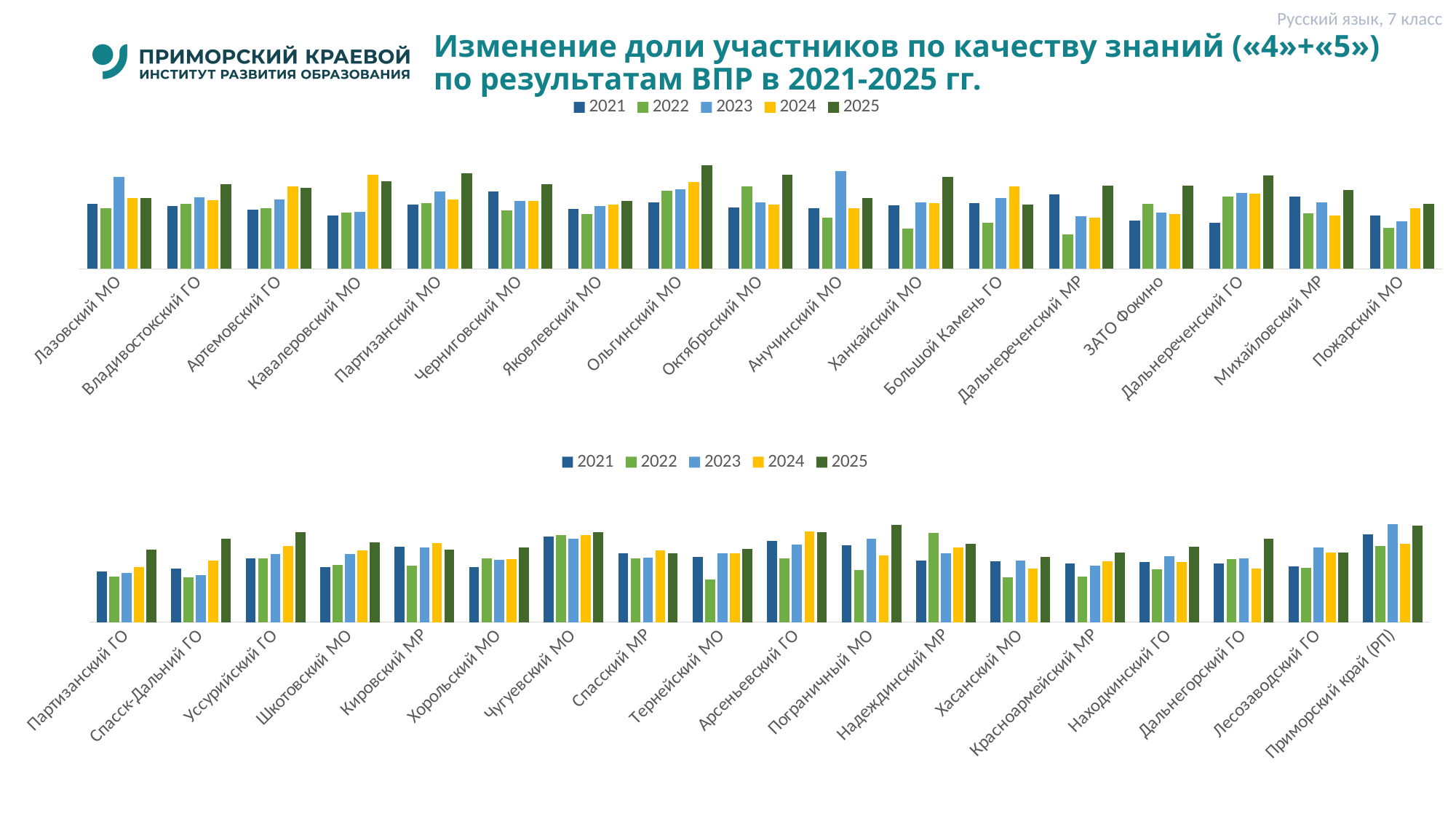
Which years are listed in the legend of the bottom chart? 2021, 2022, 2023, 2024, 2025 In the top chart, which year has the lowest bar for Дальнереченский МР? 2022 In the top chart, which year has the highest bar for Лазовский МО? 2023 How many series does the legend of the top chart list? 5 In the bottom chart, for Спасск-Дальний ГО, is the 2025 bar or the 2021 bar larger? 2025 In the bottom chart, which year has the highest bar for Надеждинский МР? 2022 How many categories are shown on the x axis of the bottom chart? 18 In the top chart, which year has the highest bar for Анучинский МО? 2023 What kind of chart is the top chart on the slide? bar chart How many categories are shown on the x axis of the top chart? 17 In the bottom chart, which year has the lowest bar for Тернейский МО? 2022 In the top chart, for Лазовский МО, is the 2023 bar or the 2022 bar larger? 2023